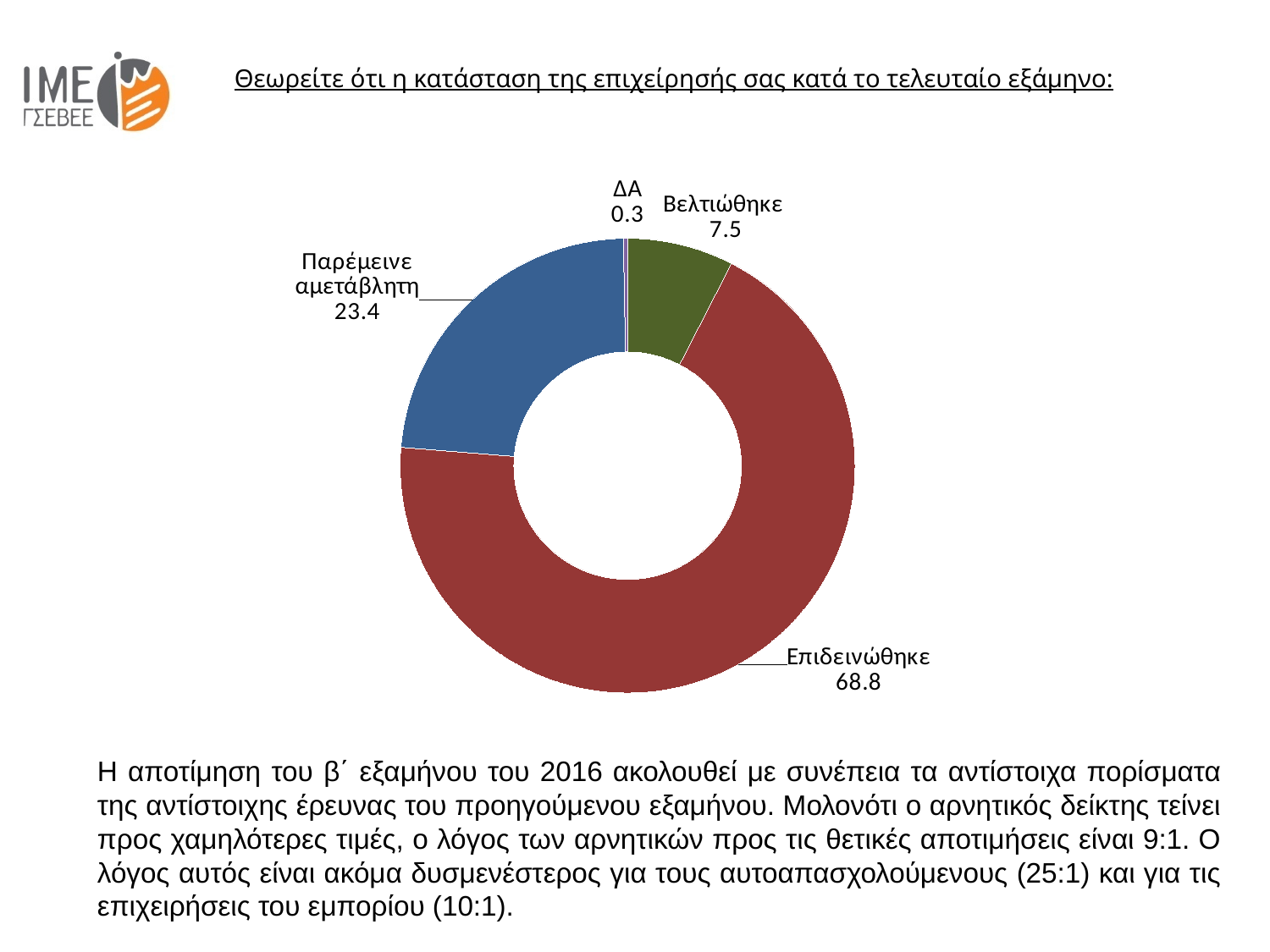
What is the difference between the values for Επιδεινώθηκε and Παρέμεινε αμετάβλητη? 45.4 What kind of chart is shown on the slide? doughnut chart What colour is the Επιδεινώθηκε segment? red Which is larger, the value for Βελτιώθηκε or the value for Παρέμεινε αμετάβλητη? Παρέμεινε αμετάβλητη What value is shown for Βελτιώθηκε? 7.5 Which category has the largest share of the chart? Επιδεινώθηκε How many categories are shown in the chart? 4 Which category has the smallest share of the chart? ΔΑ What value is shown for Παρέμεινε αμετάβλητη? 23.4 What value is shown for Επιδεινώθηκε? 68.8 What value is shown for ΔΑ? 0.3 What is the difference between the values for Παρέμεινε αμετάβλητη and Βελτιώθηκε? 15.9